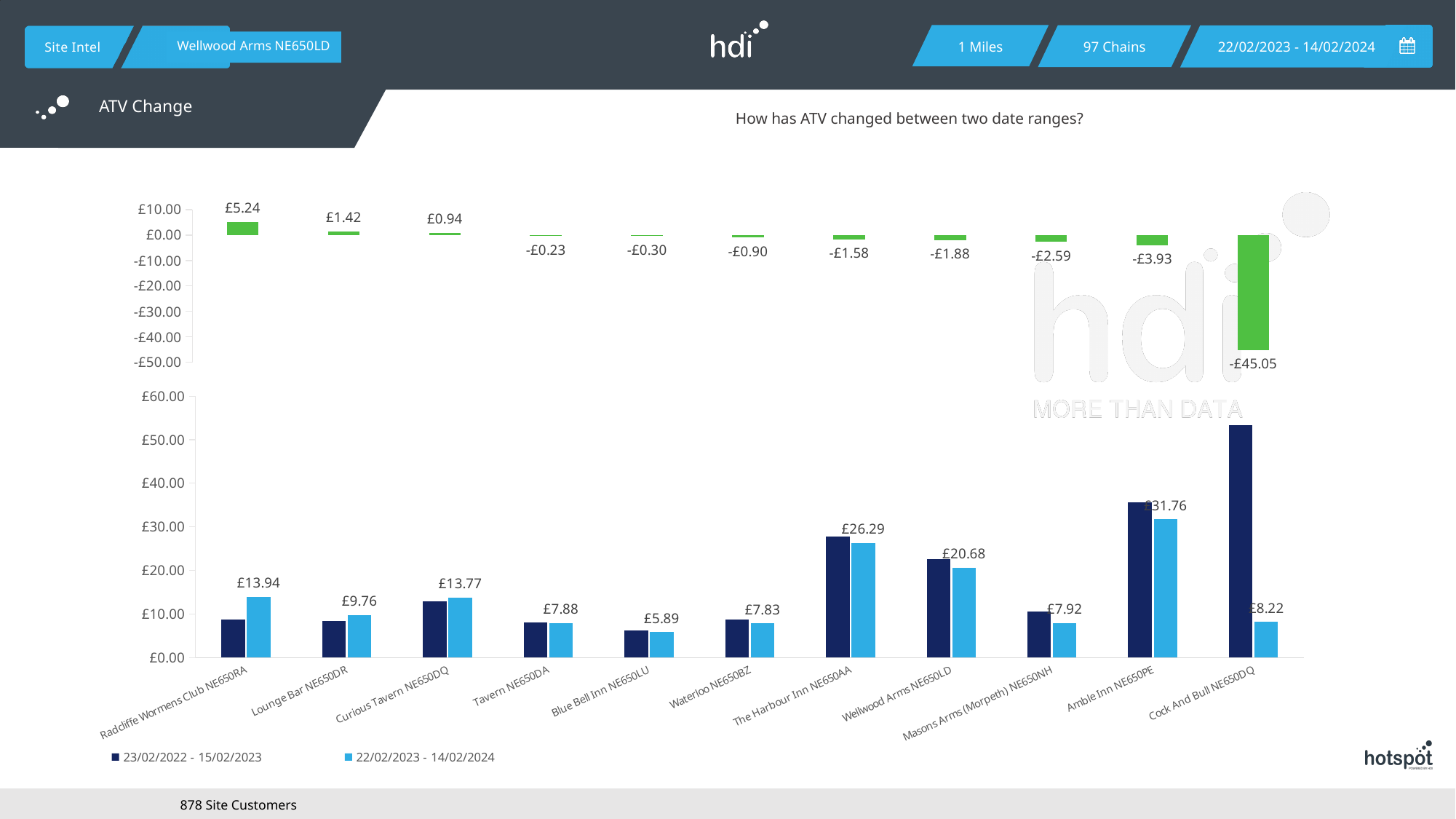
In the top chart (ATV change), what is the value for Radcliffe Wormens Club NE650RA? £5.24 In the top chart (ATV change), which site has the highest value? Radcliffe Wormens Club NE650RA In the top chart (ATV change), how many sites are plotted? 11 In the bottom chart, how many series does the legend list? 2 In the bottom chart, which has the larger value in the 22/02/2023 - 14/02/2024 series: The Harbour Inn NE650AA or Wellwood Arms NE650LD? The Harbour Inn NE650AA In the bottom chart, what is the value for Amble Inn NE650PE in the 22/02/2023 - 14/02/2024 series? £31.76 In the top chart (ATV change), which site has the lowest value? Cock And Bull NE650DQ In the top chart (ATV change), what is the value for Wellwood Arms NE650LD? -£1.88 What kind of chart is the bottom chart? bar chart In the top chart (ATV change), what is the difference between the values for Lounge Bar NE650DR and Curious Tavern NE650DQ? £0.48 In the bottom chart, is the value for Cock And Bull NE650DQ in the 23/02/2022 - 15/02/2023 series greater or less than £50.00? greater In the bottom chart, what is the difference between the 22/02/2023 - 14/02/2024 values for Amble Inn NE650PE and The Harbour Inn NE650AA? £5.47